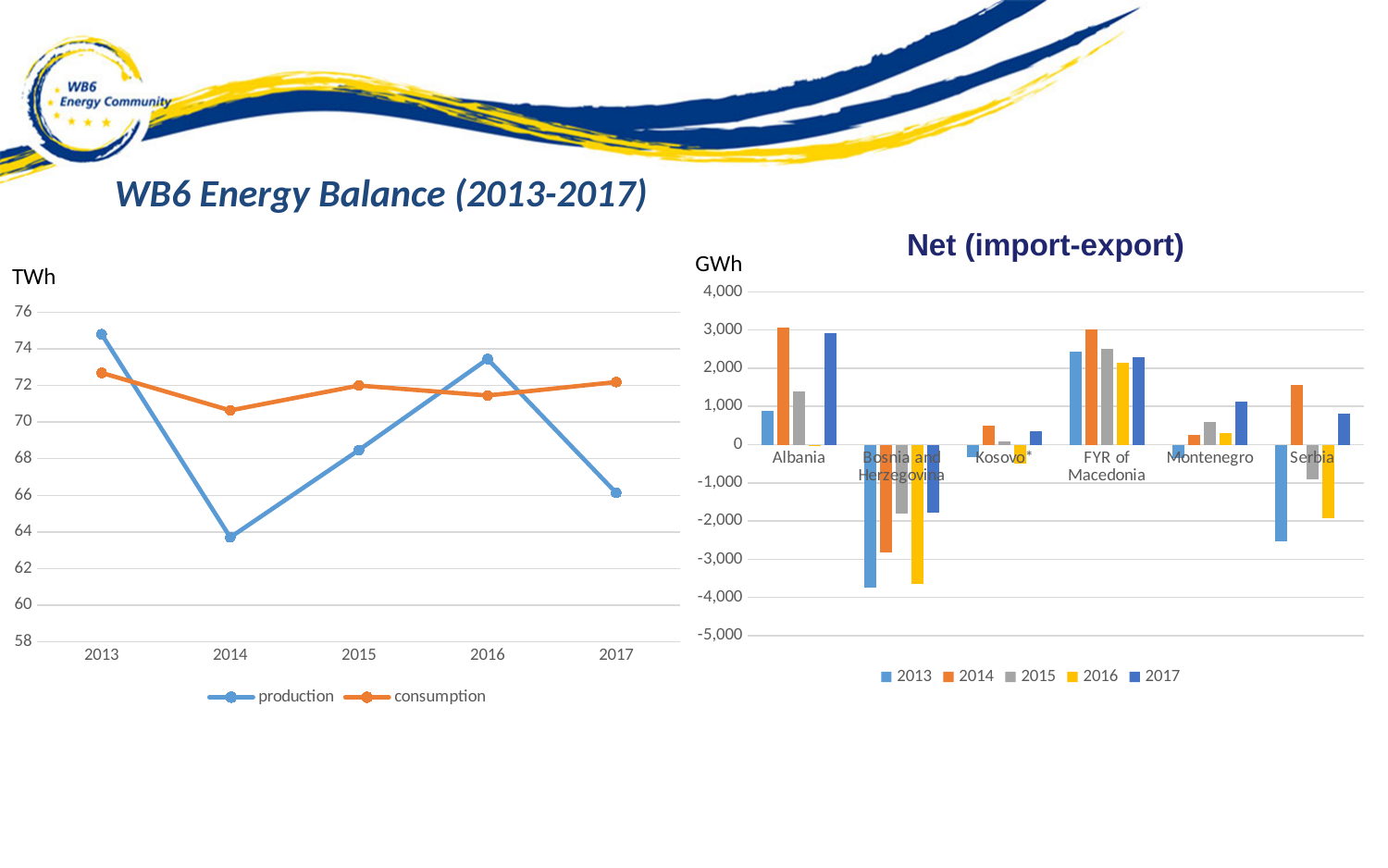
How many series does the legend of the 'Net (import-export)' chart list? 5 In the left chart, which is larger in 2016, production or consumption? production In the left chart, is production in 2014 greater or less than 66 TWh? less In the 'Net (import-export)' chart, is the 2014 value for Albania greater or less than 2,000 GWh? greater In the left chart, which year has the highest production value? 2013 What kind of chart is the 'Net (import-export)' chart? bar chart What kind of chart is the left chart showing production and consumption? line chart How many countries are shown on the x axis of the 'Net (import-export)' chart? 6 What unit is shown on the vertical axis of the 'Net (import-export)' chart? GWh In the left chart, which year has the lowest production value? 2014 How many series does the legend of the left production/consumption chart list? 2 In the 'Net (import-export)' chart, which country has the lowest (most negative) 2013 value? Bosnia and Herzegovina